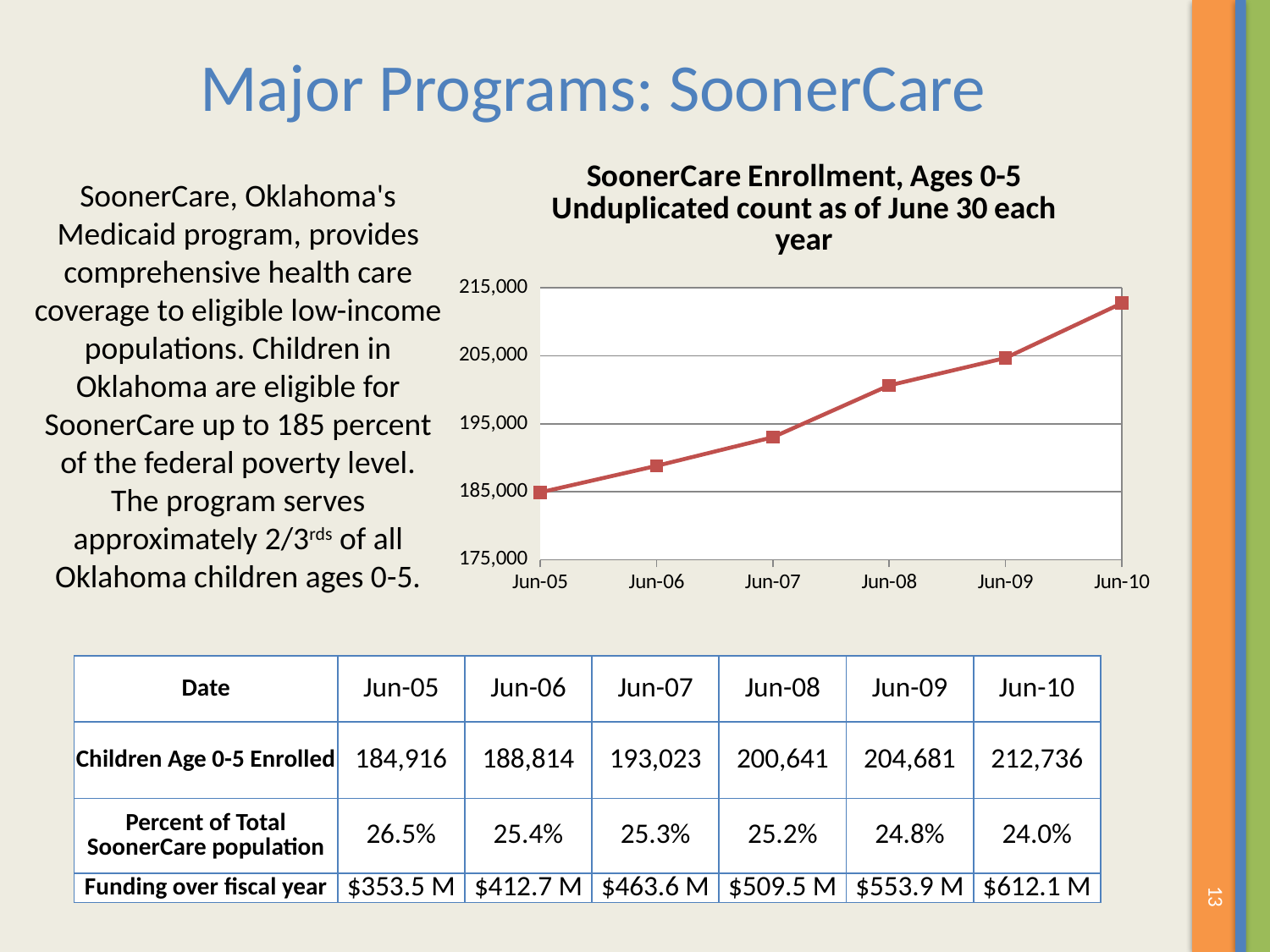
Which date has the highest enrollment on the chart? Jun-10 According to the slide, what is the difference in children age 0-5 enrolled between Jun-10 and Jun-05? 27,820 What is the title of the chart? SoonerCare Enrollment, Ages 0-5 Unduplicated count as of June 30 each year What kind of chart is shown on the slide? line chart Is the enrollment value for Jun-10 greater or less than 205,000? greater Which is larger, the enrollment for Jun-07 or for Jun-09? Jun-09 According to the slide, how many children age 0-5 were enrolled as of Jun-08? 200,641 How many data points are plotted on the line chart? 6 Which date has the lowest enrollment on the chart? Jun-05 Do the enrollment values rise or fall from Jun-05 to Jun-10? rise Is the enrollment value for Jun-08 greater or less than 195,000? greater Is the enrollment value for Jun-06 greater or less than 195,000? less